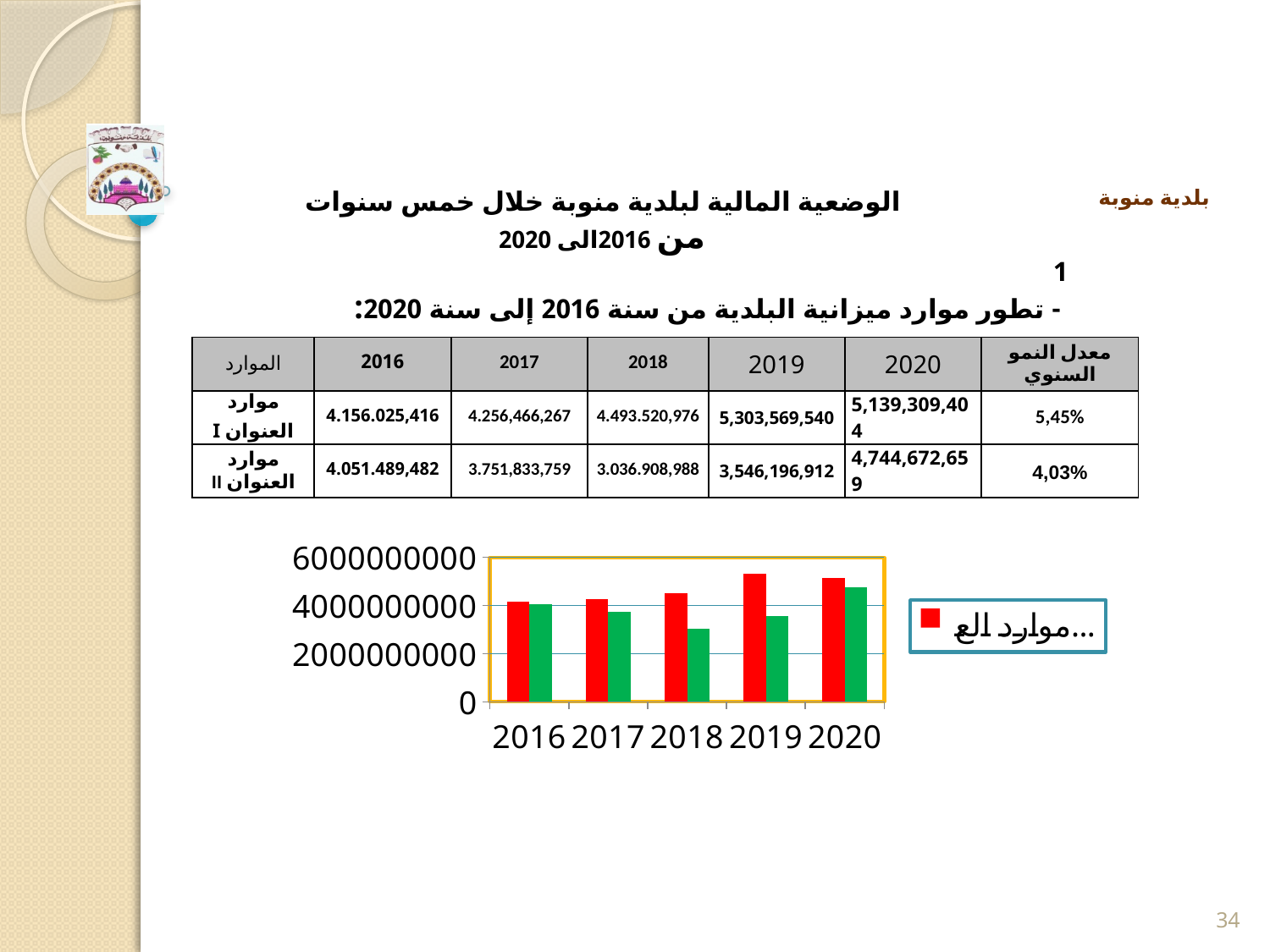
What kind of chart is shown on the slide? bar chart Which year has the shortest green bar in the chart? 2018 Is the green bar for 2017 greater or less than 4000000000? less In 2020, which bar is taller, the red one or the green one? red How many years are shown on the x axis of the chart? 5 In 2019, which bar is taller, the red one or the green one? red Do the green bars rise or fall from 2016 to 2018? fall Is the green bar for 2018 greater or less than 4000000000? less Is the red bar for 2019 greater or less than 4000000000? greater What colour is the series shown in the chart's legend? red Which year has the tallest red bar in the chart? 2019